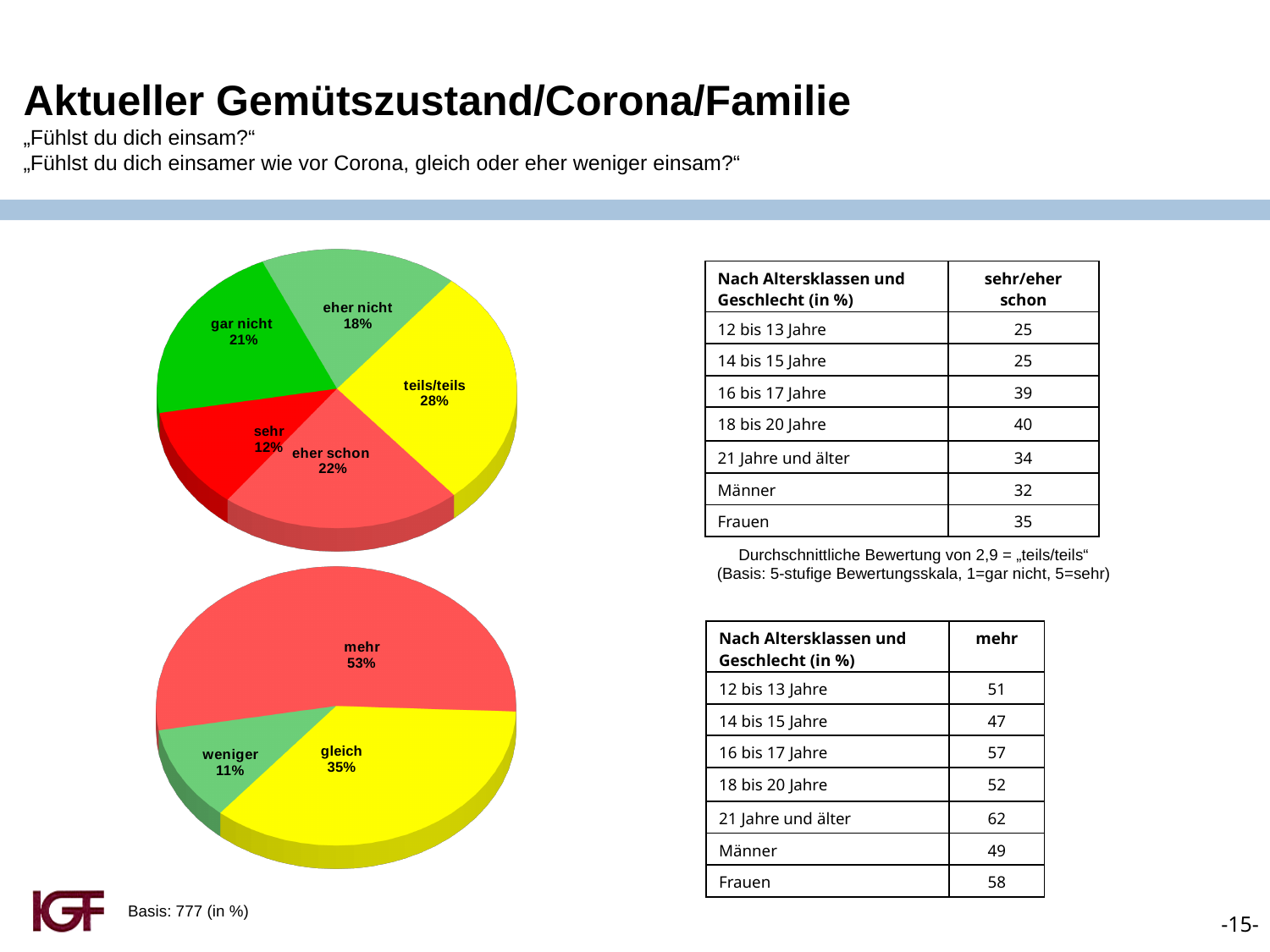
In the top pie chart, what percentage is shown for "sehr"? 12% In the top pie chart, which is larger: "eher schon" or "gar nicht"? eher schon How many slices does the top pie chart have? 5 In the top pie chart, which slice has the smallest share? sehr In the bottom pie chart, what is the difference in percentage points between "mehr" and "gleich"? 18 In the bottom pie chart, what percentage is shown for "mehr"? 53% In the top pie chart, what percentage is shown for "teils/teils"? 28% How many slices does the bottom pie chart have? 3 In the top pie chart, which slice has the largest share? teils/teils In the bottom pie chart, what percentage is shown for "weniger"? 11% In the top pie chart, what is the difference in percentage points between "gar nicht" and "eher nicht"? 3 What type of chart is the bottom chart on the slide? pie chart